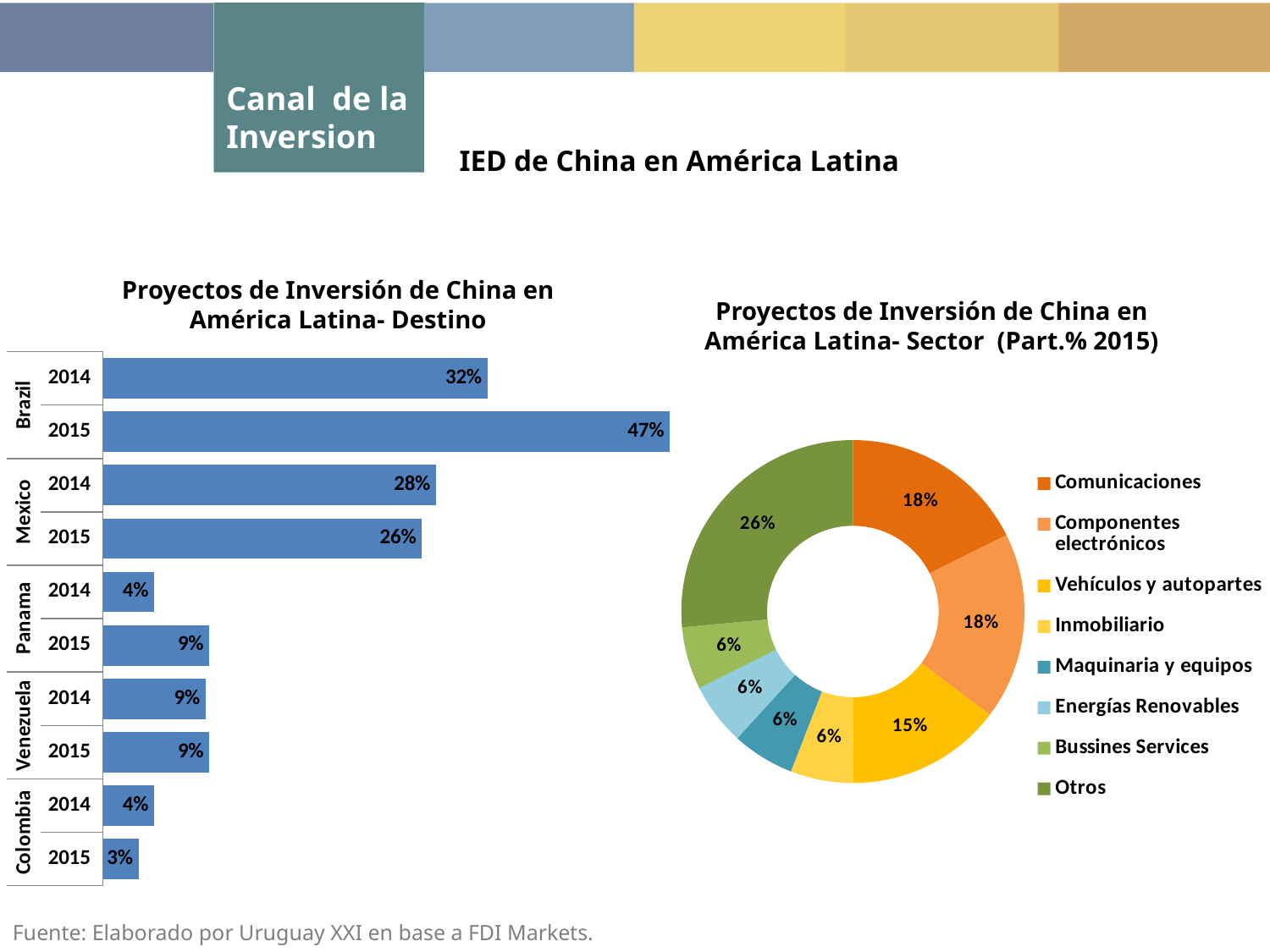
What kind of chart is 'Proyectos de Inversión de China en América Latina- Destino'? Bar chart In the 'Proyectos de Inversión de China en América Latina- Sector (Part.% 2015)' chart, what share does Otros have? 26% In the 'Proyectos de Inversión de China en América Latina- Destino' chart, what is the value for Brazil in 2015? 47% In the 'Proyectos de Inversión de China en América Latina- Sector (Part.% 2015)' chart, what is the value for Vehículos y autopartes? 15% In the 'Proyectos de Inversión de China en América Latina- Destino' chart, what is the value for Mexico in 2014? 28% In the 'Proyectos de Inversión de China en América Latina- Destino' chart, which bar has the highest value? Brazil 2015 In the 'Proyectos de Inversión de China en América Latina- Destino' chart, how many bars are plotted? 10 In the 'Proyectos de Inversión de China en América Latina- Destino' chart, what is the difference between Brazil's 2015 and 2014 values? 15% In the 'Proyectos de Inversión de China en América Latina- Destino' chart, which bar has the lowest value? Colombia 2015 In the 'Proyectos de Inversión de China en América Latina- Destino' chart, which is larger: Mexico 2014 or Mexico 2015? Mexico 2014 In the 'Proyectos de Inversión de China en América Latina- Sector (Part.% 2015)' chart, how many sectors does the legend list? 8 In the 'Proyectos de Inversión de China en América Latina- Sector (Part.% 2015)' chart, which colour represents Comunicaciones? Orange